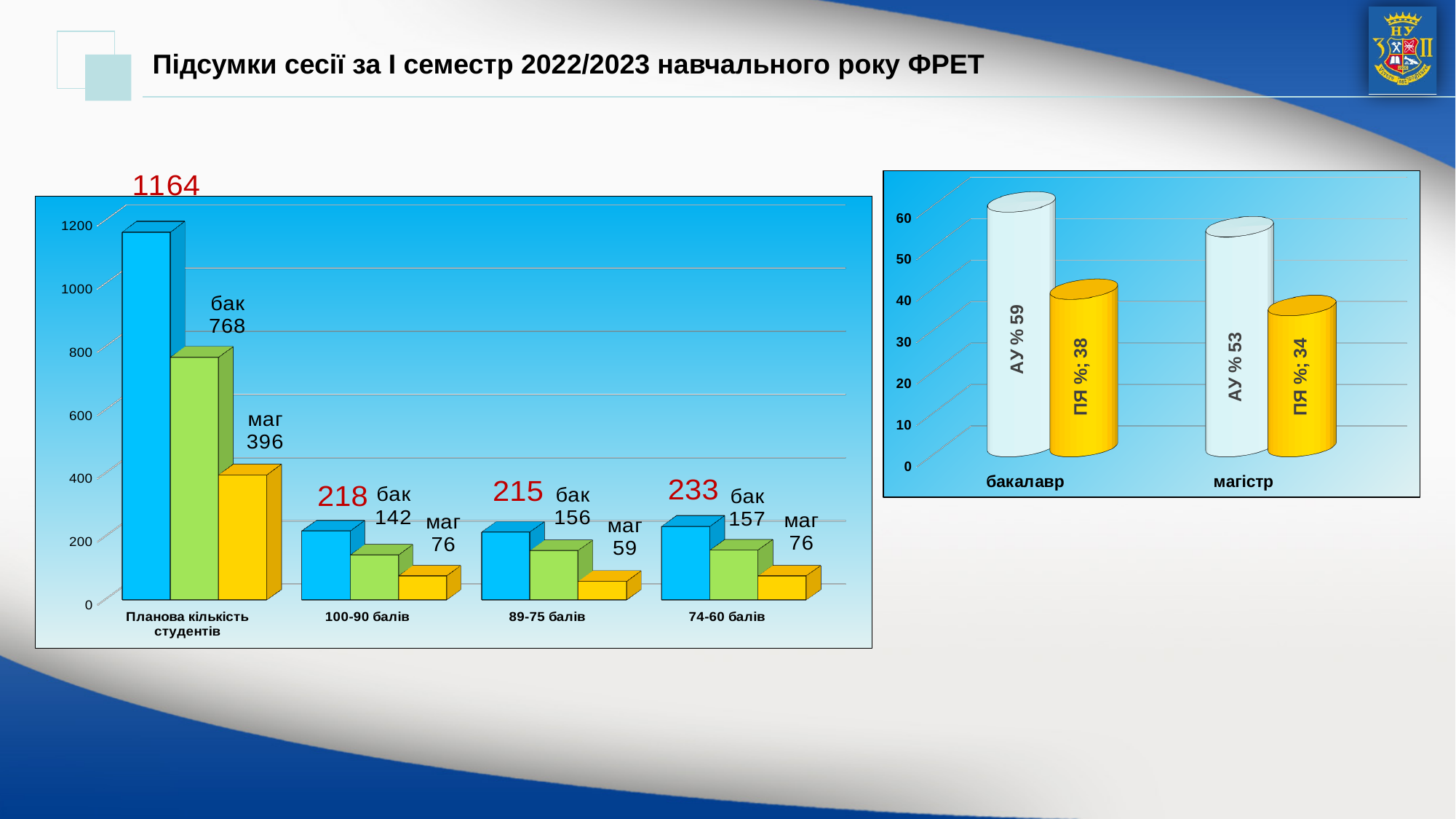
On the right chart, what is the 'АУ %' value for 'бакалавр'? 59 On the left chart, what is the difference between the 'бак' and 'маг' values for 'Планова кількість студентів'? 372 On the right chart, how many categories are shown on the x axis? 2 On the left chart, how many categories are shown on the x axis? 4 On the left chart, what is the 'бак' value for the '89-75 балів' category? 156 On the left chart, which of the three score categories ('100-90 балів', '89-75 балів', '74-60 балів') has the highest blue bar value? 74-60 балів On the left chart, what is the 'маг' value for the '100-90 балів' category? 76 On the right chart, what is the difference between the 'АУ %' values for 'бакалавр' and 'магістр'? 6 On the left chart, what is the value of the blue bar for 'Планова кількість студентів'? 1164 On the left chart, which is larger: the 'маг' value for '89-75 балів' or the 'маг' value for '74-60 балів'? 74-60 балів What kind of chart is the left chart? bar chart On the right chart, what is the 'ПЯ %' value for 'магістр'? 34